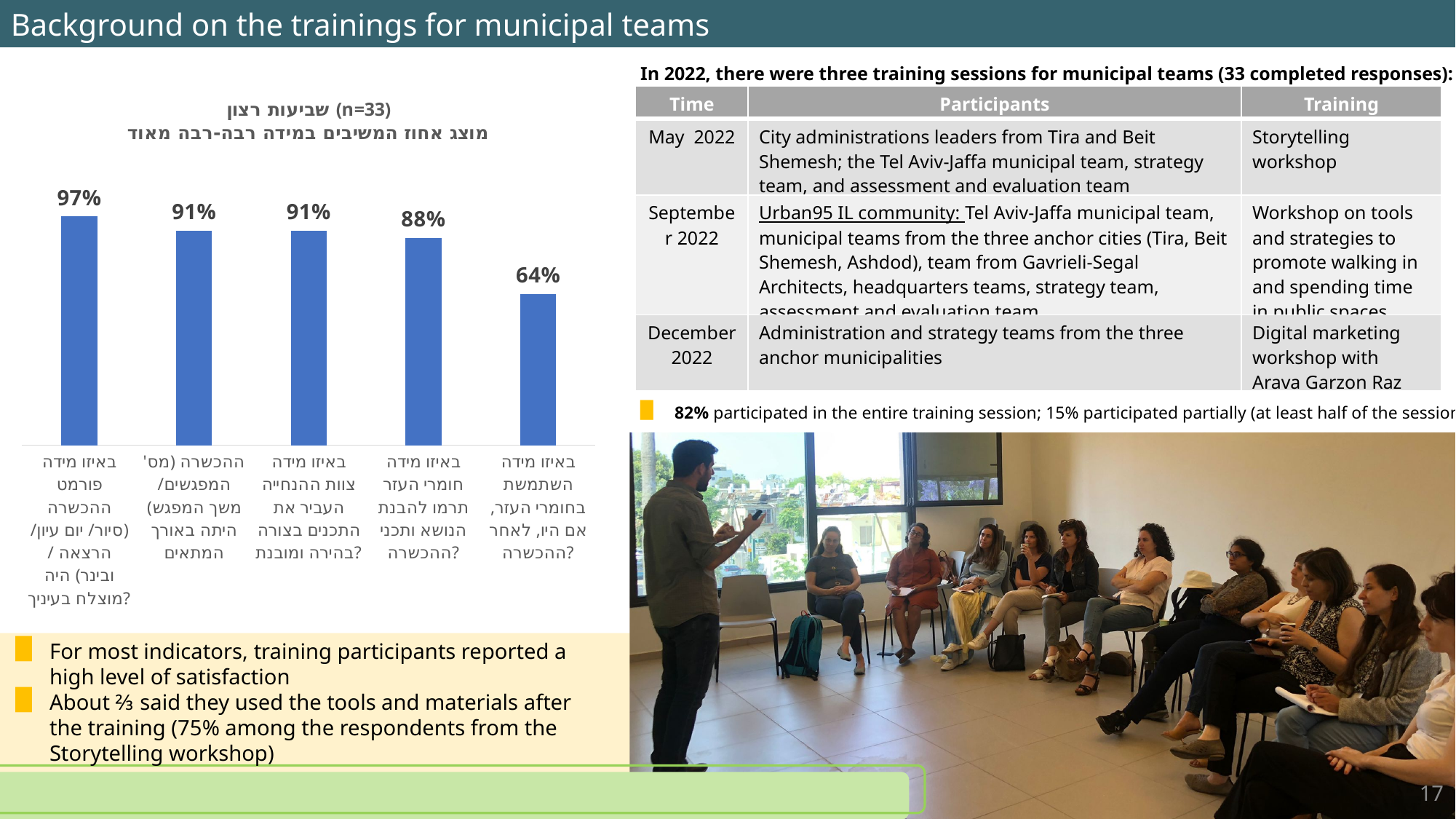
What is the value of the rightmost bar in the chart (the question about using the support materials after the training, השתמשת בחומרי העזר)? 64% Which bar in the chart has the lowest value? The rightmost bar (use of support materials after the training), 64% Which is larger: the bar for the support materials contributing to understanding (88%) or the bar for using the support materials after the training (64%)? Support materials contributing to understanding (88%) What is the value of the bar for the question about whether the support materials contributed to understanding the topic (חומרי העזר תרמו להבנת הנושא)? 88% What is the value of the leftmost bar in the chart (the question about the training format, פורמט ההכשרה)? 97% Do the bar values generally rise or fall moving from left to right across the chart? fall What type of chart is shown on the left of the slide? bar chart What is the difference between the highest bar (97%) and the lowest bar (64%) in the chart? 33 percentage points How many bars (categories) does the bar chart on the left show? 5 What is the value of the bar for the question about the training being the appropriate length (היתה באורך המתאים)? 91% What sample size (n) is stated in the chart title? n=33 Which bar in the chart has the highest value? The leftmost bar (training format, פורמט ההכשרה), 97%